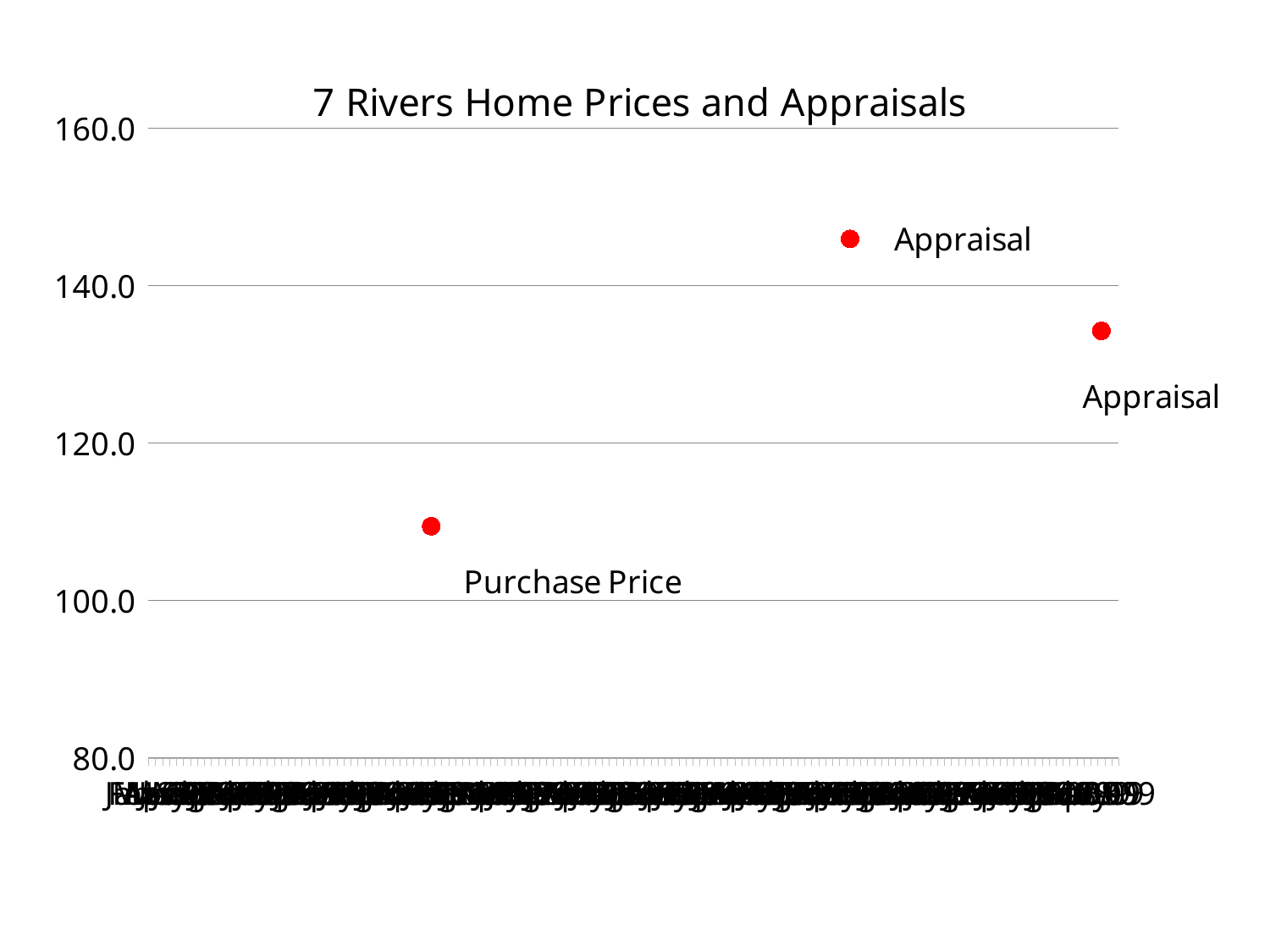
What colour are the plotted points? red Which labelled point has the lowest value? Purchase Price Is the value for Purchase Price greater or less than 120? less How many data points are plotted on the chart? 3 What is the title of the chart? 7 Rivers Home Prices and Appraisals Which of the two Appraisal points has the higher value, the left one or the right one? the left one Is the value for Purchase Price greater or less than 100? greater Is the value of the rightmost Appraisal point greater or less than 120? greater What kind of chart is shown on the slide? scatter chart Which is larger, the Purchase Price or the rightmost Appraisal value? the rightmost Appraisal